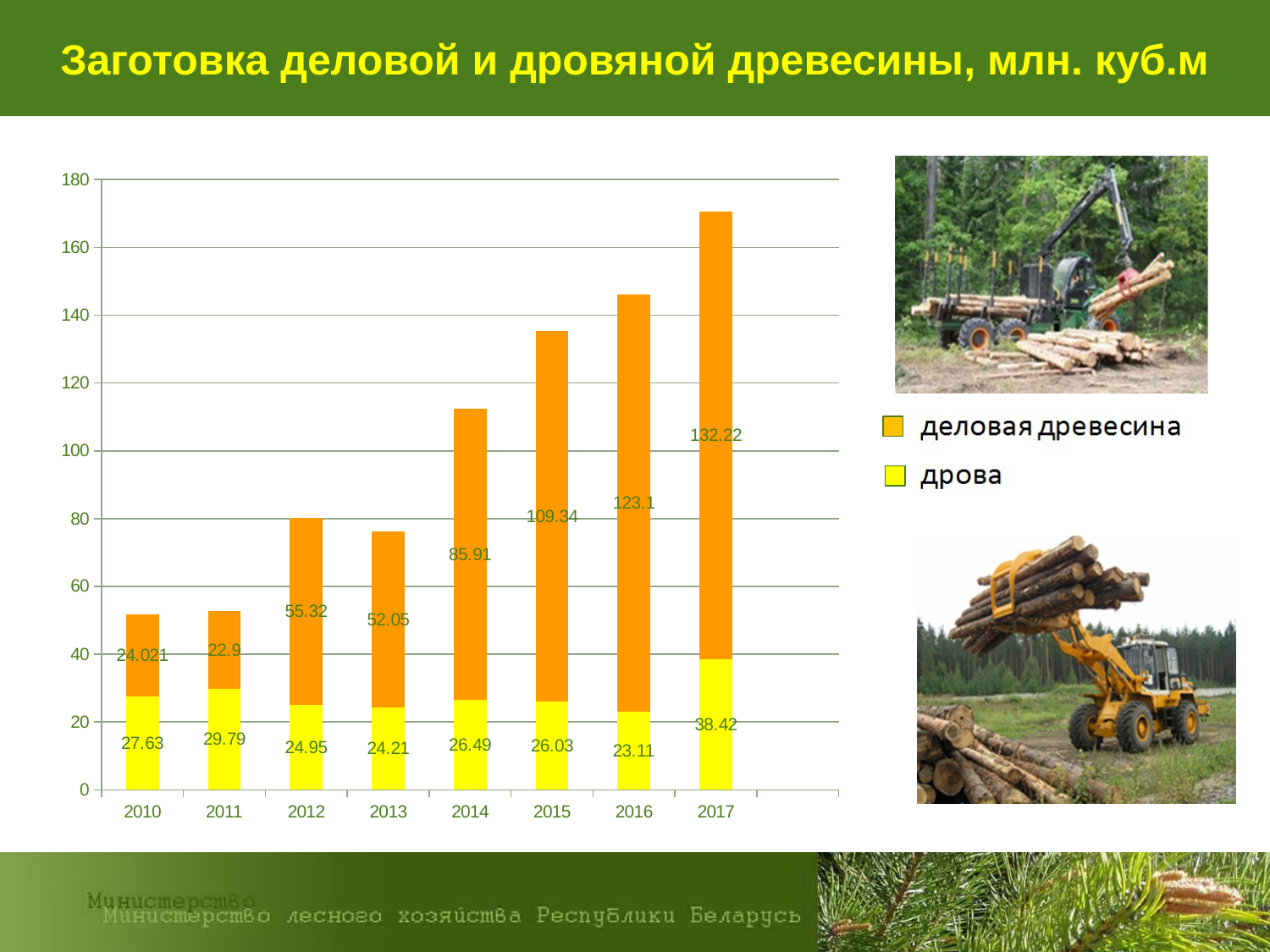
Which is larger: дрова in 2010 or дрова in 2013? дрова in 2010 What is the value for деловая древесина in 2017? 132.22 What is the value for деловая древесина in 2014? 85.91 What is the total of the stacked bar for 2017? 170.64 What kind of chart is shown on the slide? stacked bar chart How many years are shown on the x axis? 8 How many series does the legend list? 2 Which year has the highest value for деловая древесина? 2017 What is the value for дрова in 2011? 29.79 What is the difference between деловая древесина in 2017 and in 2016? 9.12 Is the total of the stacked bar for 2015 greater or less than 120? greater Which year has the lowest value for дрова? 2016